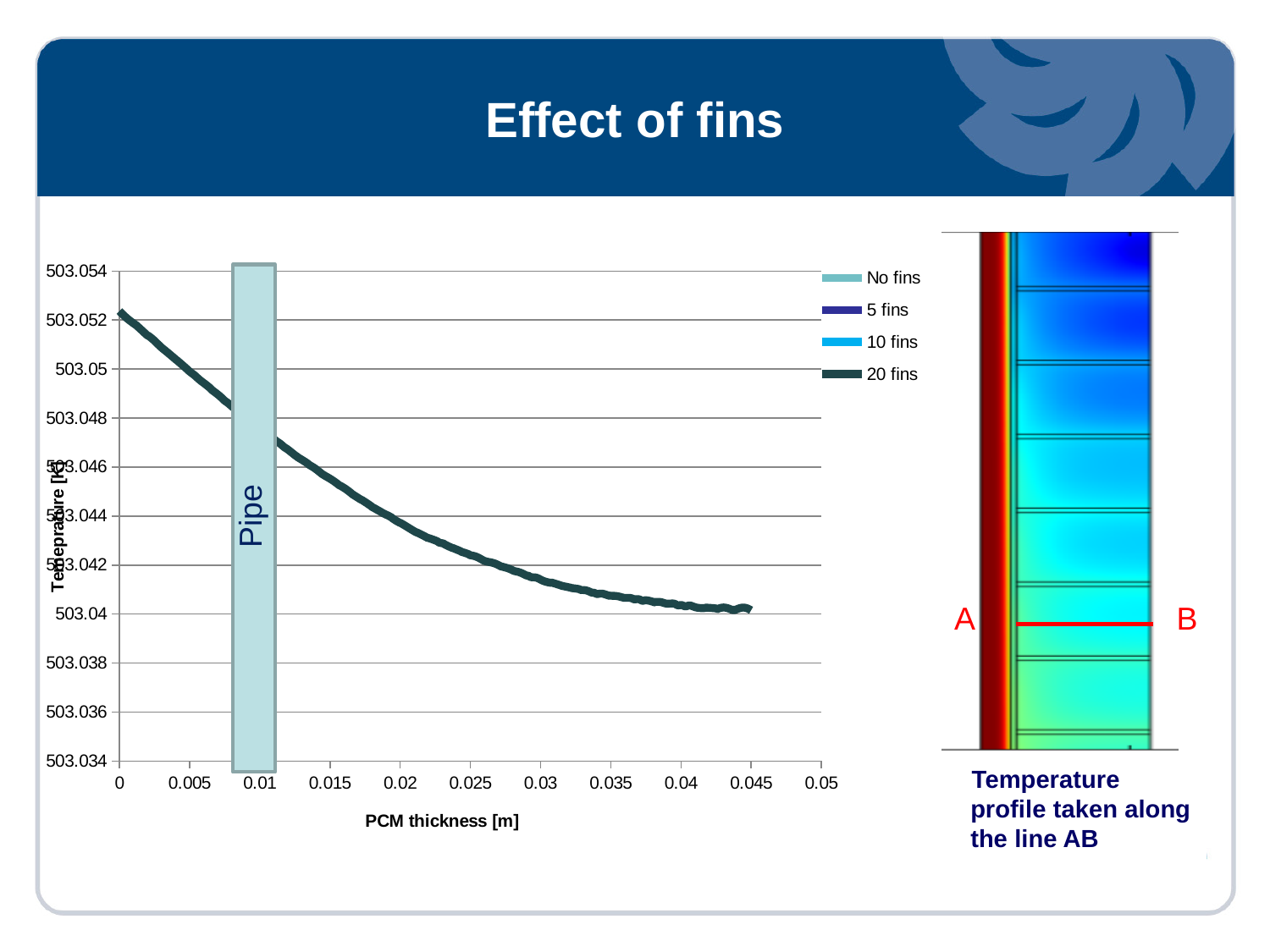
How many series does the chart legend list? 4 Which is larger, the plotted temperature at a PCM thickness of 0.005 m or at 0.04 m? 0.005 m Is the plotted temperature at a PCM thickness of 0.01 m greater or less than 503.05? less What is the label of the x axis of the chart? PCM thickness [m] Is the plotted temperature at a PCM thickness of 0.03 m greater or less than 503.042? less Is the plotted temperature at a PCM thickness of 0.025 m greater or less than 503.044? less Does the plotted temperature rise or fall as PCM thickness increases along the x axis? fall What is the title of the slide containing the chart? Effect of fins What kind of chart is shown on the slide? line chart At which PCM thickness shown on the x axis does the plotted line reach its highest temperature? 0